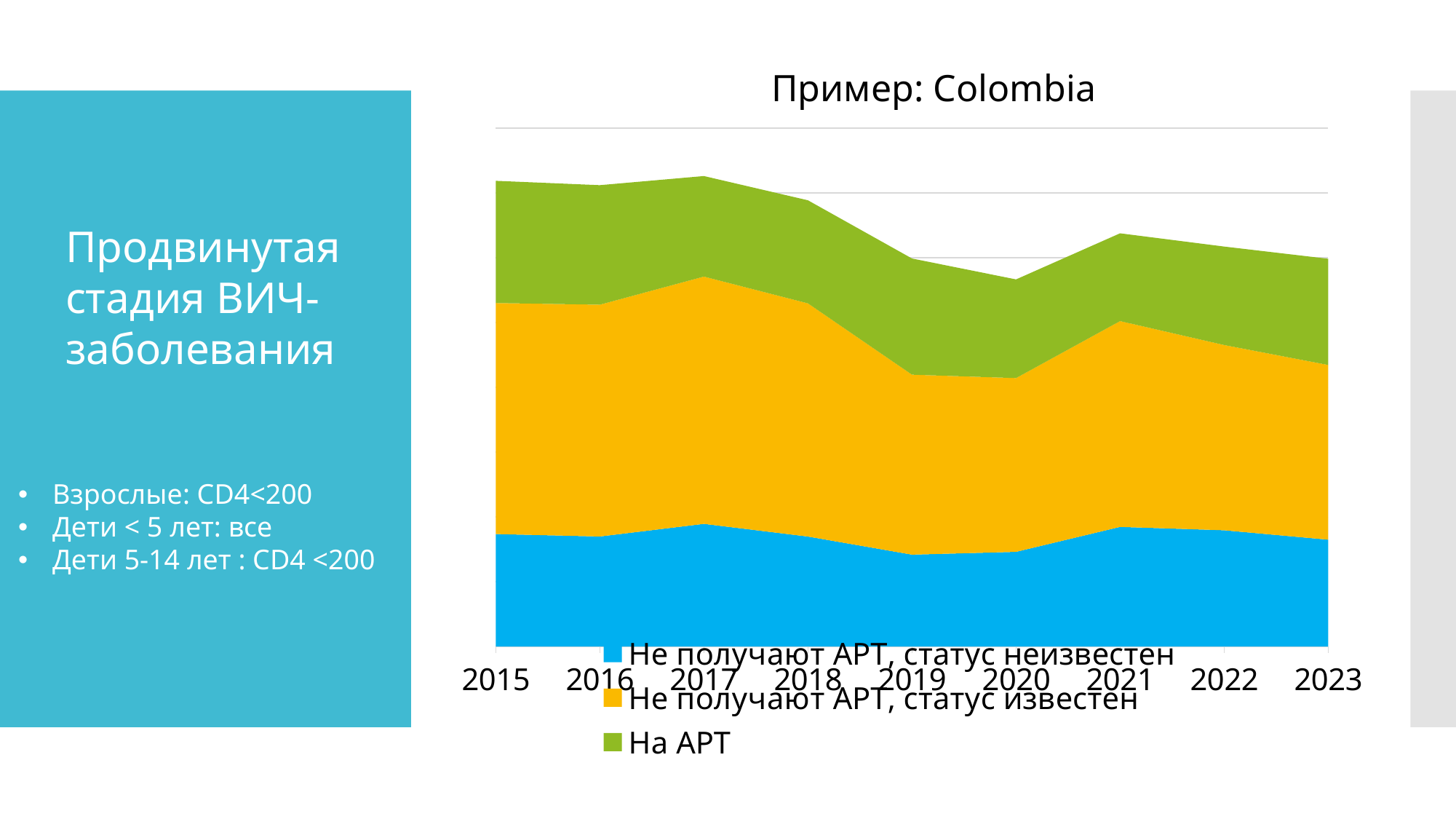
What is the title of the chart? Пример: Colombia What is the last year shown on the x axis of the chart? 2023 In which year is the total stacked value highest? 2017 How many years are shown along the x axis of the chart? 9 Is the total stacked value larger in 2015 or in 2023? 2015 Does the total stacked value rise or fall from 2020 to 2021? rise How many series does the chart's legend list? 3 Does the total stacked value rise or fall from 2017 to 2020? fall What kind of chart is shown on the slide? stacked area chart Which series is shown in green in the chart? На АРТ What is the first year shown on the x axis of the chart? 2015 In which year is the total stacked value lowest? 2020